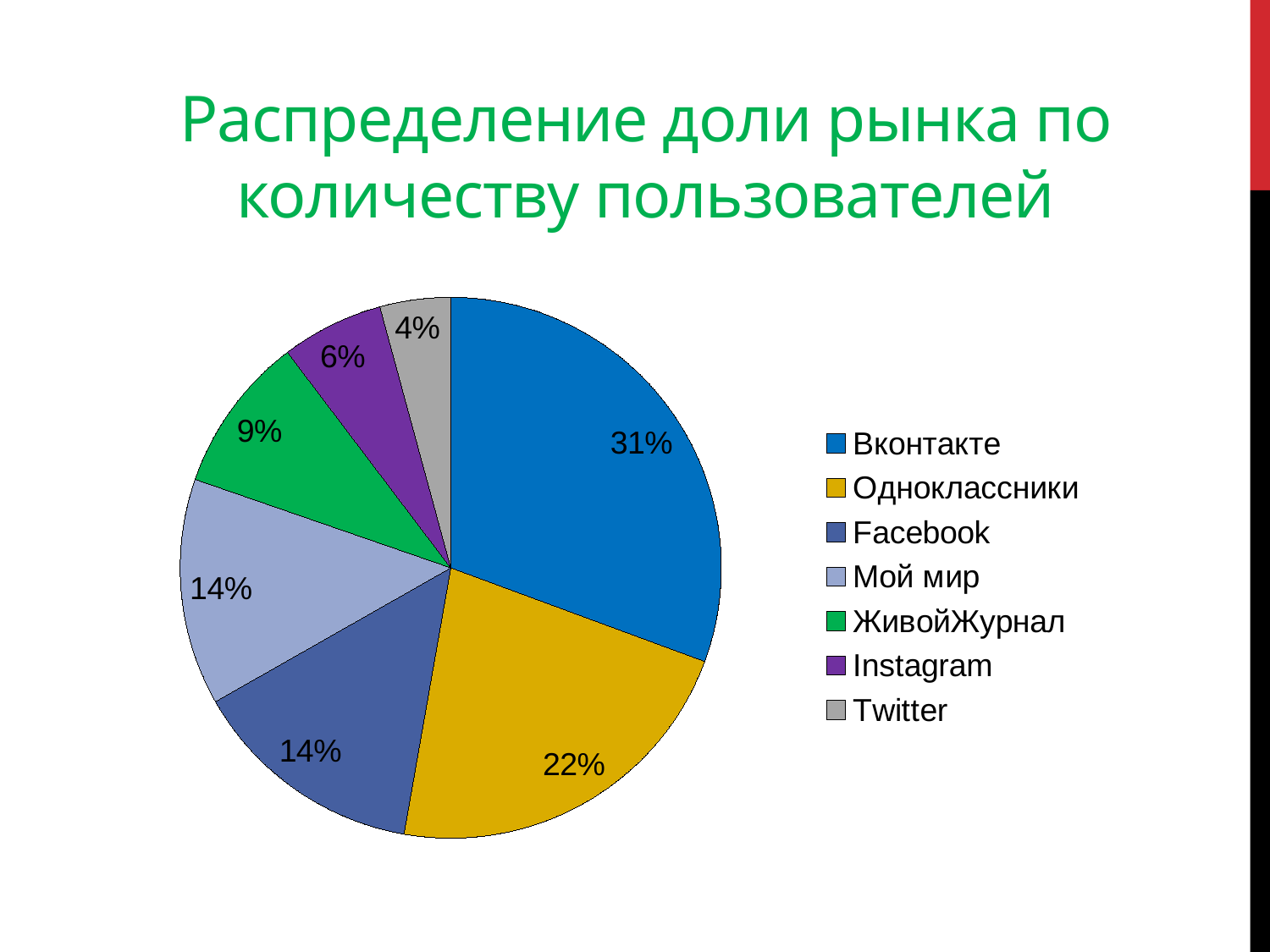
What is the value shown for Одноклассники? 22% Which is larger, the share of Instagram or the share of ЖивойЖурнал? ЖивойЖурнал What share of the pie does Вконтакте have? 31% Which category has the largest slice of the pie? Вконтакте What is the difference between the shares of Вконтакте and Одноклассники? 9% What is the value shown for Twitter? 4% What kind of chart is shown on the slide? Pie chart Which category is shown in green in the legend? ЖивойЖурнал What is the value shown for ЖивойЖурнал? 9% Which category has the smallest slice of the pie? Twitter How many categories does the pie chart show? 7 What is the title of the chart on the slide? Распределение доли рынка по количеству пользователей